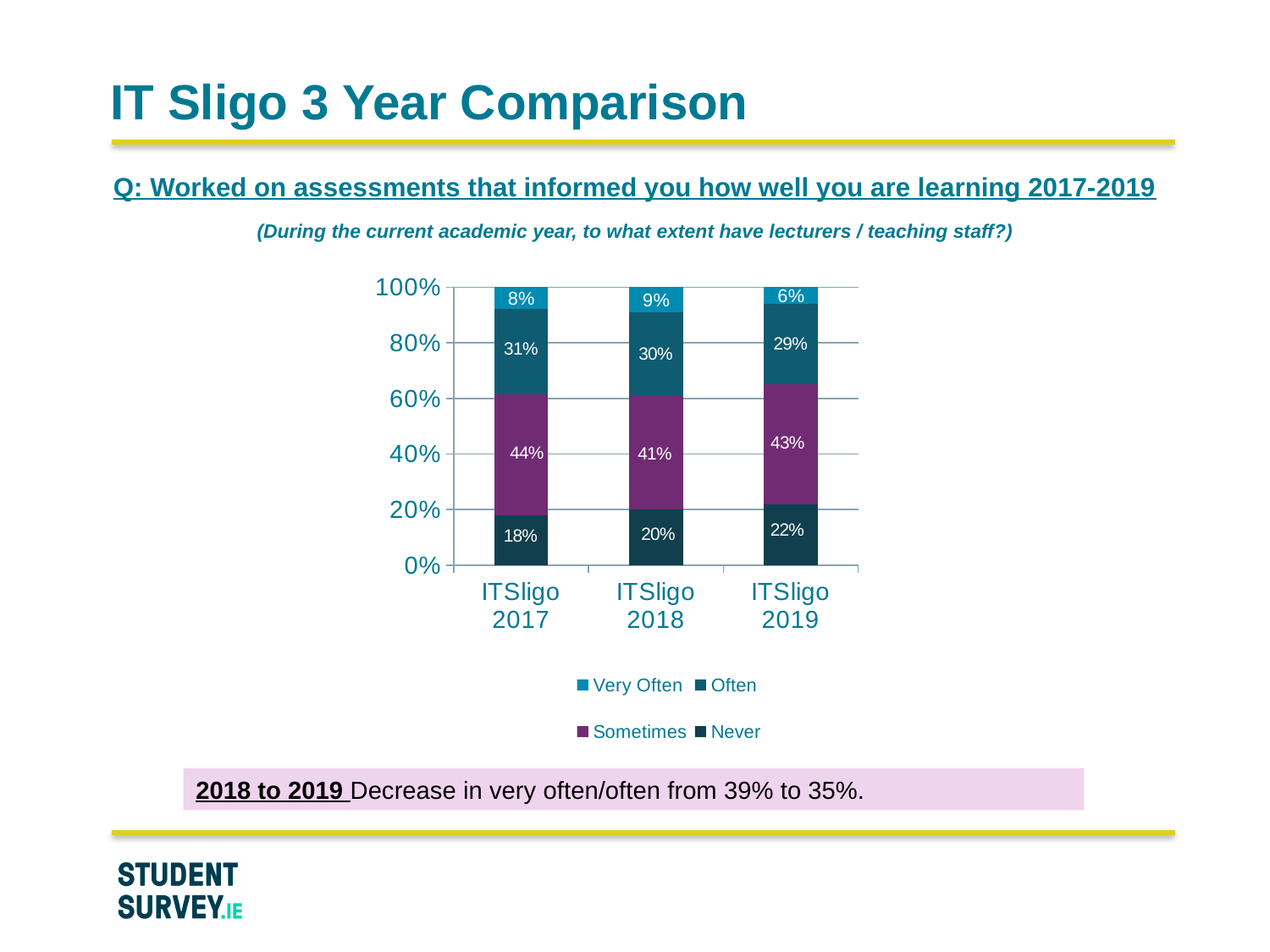
Is the Often value larger for ITSligo 2017 or ITSligo 2019? ITSligo 2017 How many years (categories) are shown on the x axis? 3 How many series does the legend list? 4 What percentage of ITSligo 2017 respondents answered Never? 18% What kind of chart is shown on the slide? Stacked bar chart What is the difference between the Sometimes values for ITSligo 2017 and ITSligo 2018? 3% Which year has the highest Never value? ITSligo 2019 Does the Never value rise or fall from ITSligo 2017 to ITSligo 2019? Rise What is the Sometimes value for ITSligo 2018? 41% Which year has the lowest Very Often value? ITSligo 2019 What is the Often value for ITSligo 2017? 31% What is the Very Often value for ITSligo 2019? 6%